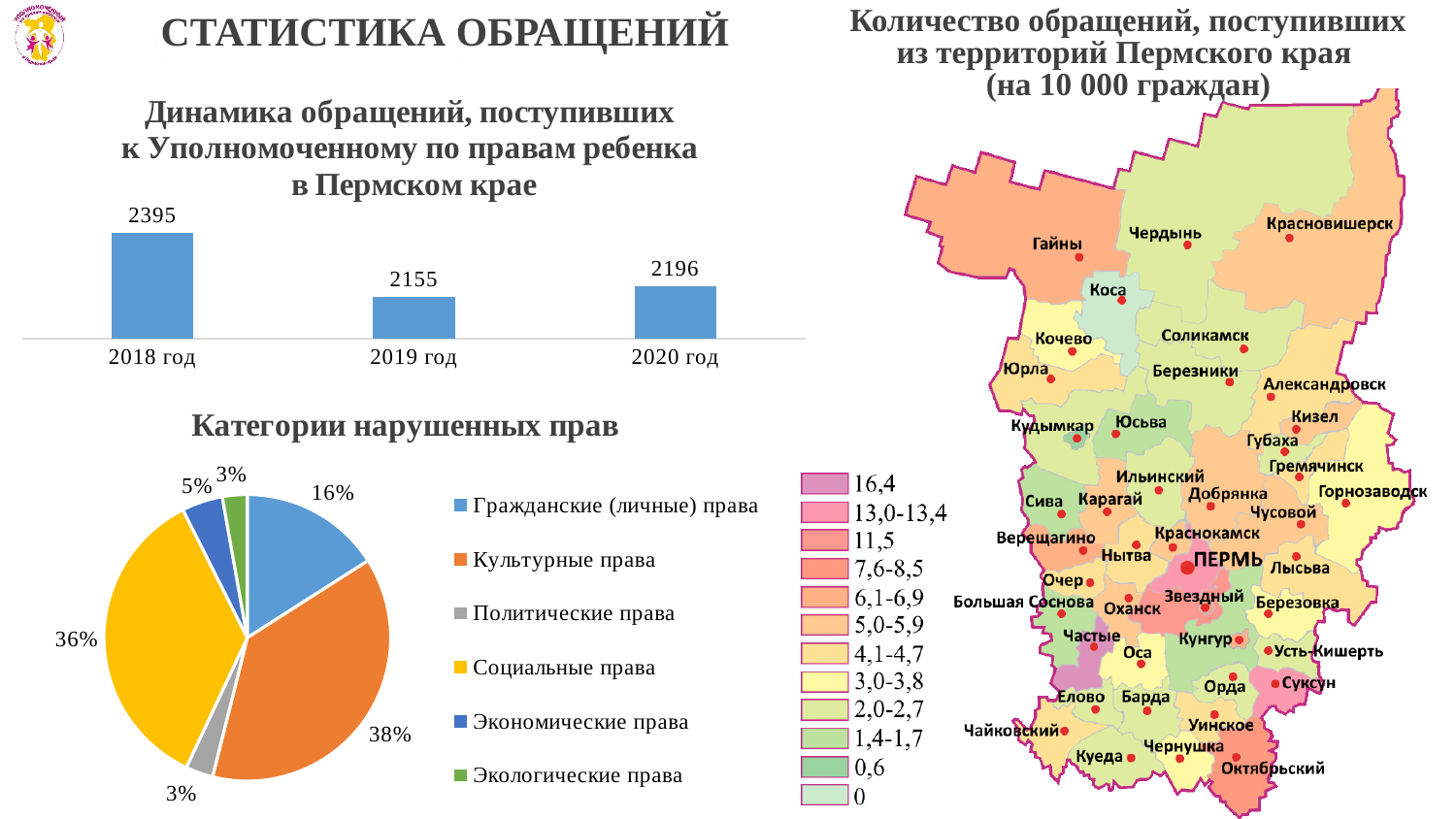
In the pie chart 'Категории нарушенных прав', which is larger: Гражданские (личные) права or Экономические права? Гражданские (личные) права In the bar chart 'Динамика обращений, поступивших к Уполномоченному по правам ребенка в Пермском крае', what is the value for 2018 год? 2395 In the bar chart 'Динамика обращений...', what is the difference between the values for 2018 год and 2020 год? 199 In the pie chart 'Категории нарушенных прав', which category has the largest share? Культурные права In the pie chart 'Категории нарушенных прав', how many categories does the legend list? 6 In the bar chart 'Динамика обращений...', which year has the lowest value? 2019 год What kind of chart is 'Динамика обращений, поступивших к Уполномоченному по правам ребенка в Пермском крае'? bar chart In the bar chart 'Динамика обращений...', what is the value for 2019 год? 2155 In the pie chart 'Категории нарушенных прав', what share is Социальные права? 36% In the bar chart 'Динамика обращений...', which year has the highest value? 2018 год In the bar chart 'Динамика обращений...', how many years are shown? 3 In the pie chart 'Категории нарушенных прав', what share is Культурные права? 38%